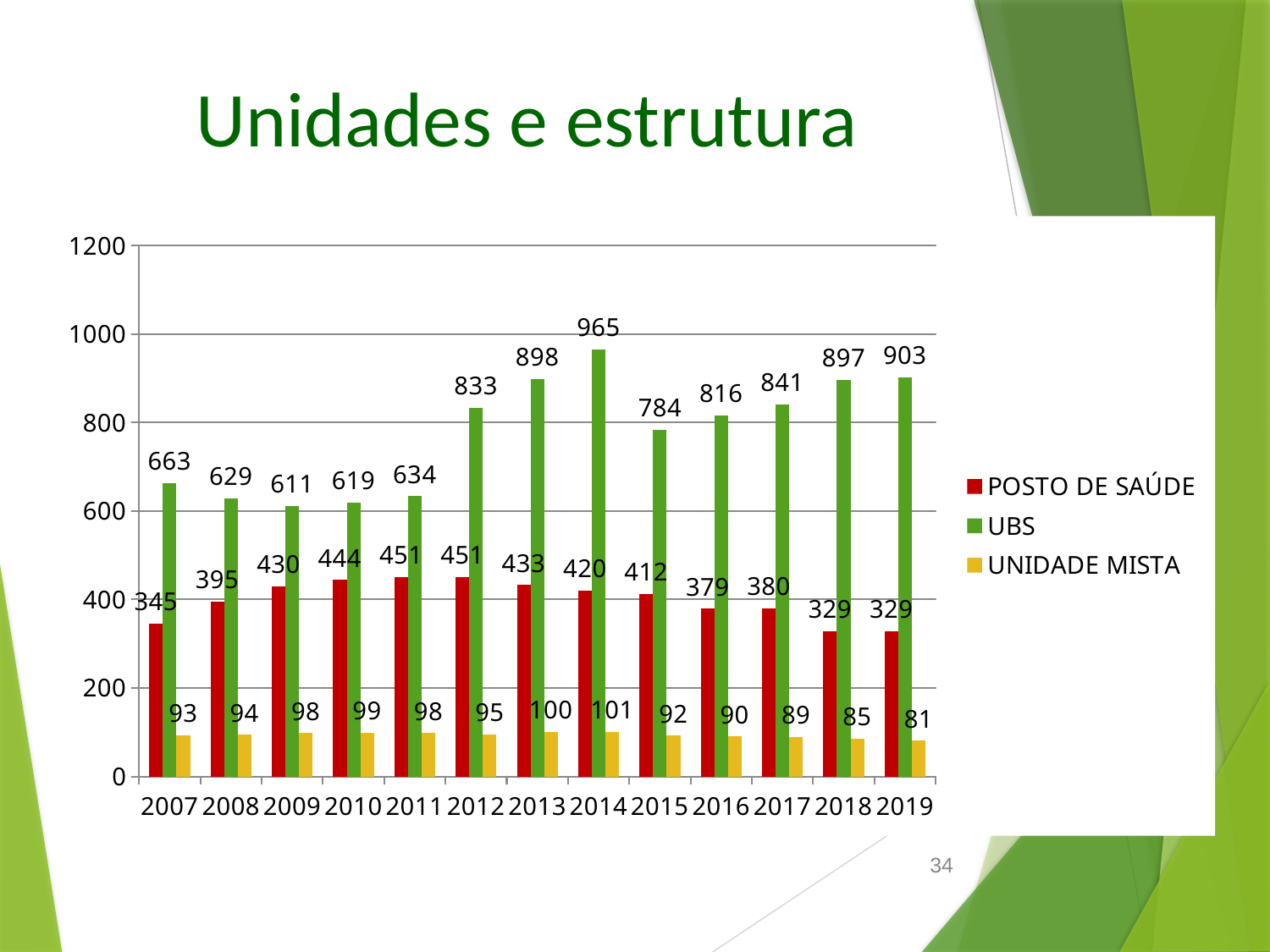
In which year is the UNIDADE MISTA value lowest? 2019 How many years are shown on the x axis? 13 In which year is the UBS value highest? 2014 What kind of chart is shown on the slide? bar chart Which is larger, the POSTO DE SAÚDE value for 2008 or for 2016? 2008 What is the POSTO DE SAÚDE value for 2011? 451 Which colour represents UBS in the chart? green What is the difference between the UBS values for 2019 and 2007? 240 How many series does the legend list? 3 Is the UBS value for 2015 greater or less than 800? less What is the UBS value for 2014? 965 What is the UNIDADE MISTA value for 2019? 81